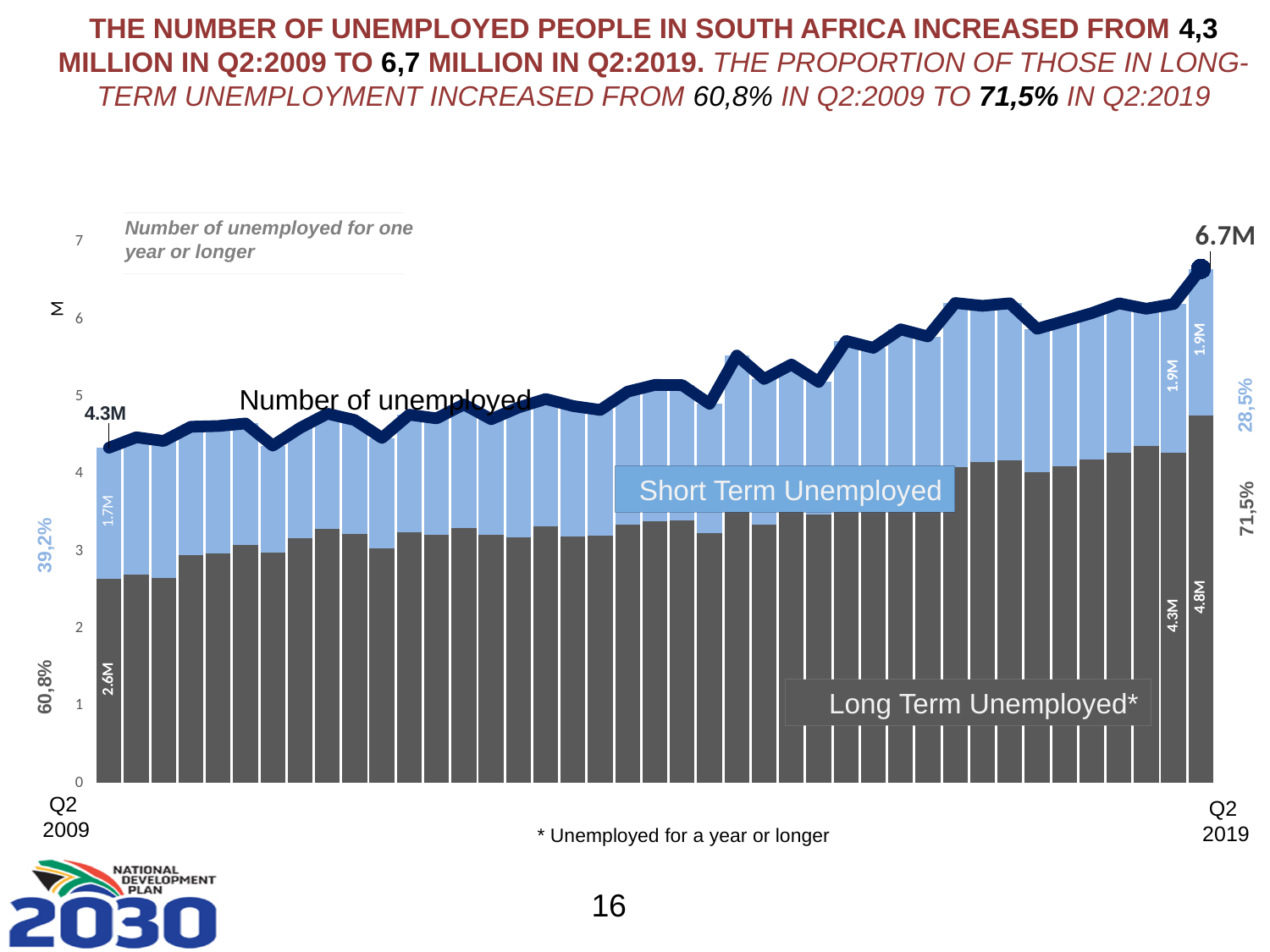
Does the number of unemployed generally rise or fall from Q2 2009 to Q2 2019? Rise What was the total number of unemployed people in Q2 2019 according to the chart? 6.7M By how much did the total number of unemployed increase from Q2 2009 to Q2 2019? 2.4M How many people were long term unemployed in Q2 2019? 4.8M In Q2 2019, which was larger: the number of long term unemployed or short term unemployed? Long term unemployed By how much did the number of long term unemployed increase from Q2 2009 to Q2 2019? 2.2M How many people were long term unemployed in Q2 2009? 2.6M How many people were short term unemployed in Q2 2009? 1.7M What kind of chart is used to show the long term and short term unemployed? Stacked bar chart What was the total number of unemployed people in Q2 2009 according to the chart? 4.3M What proportion of the unemployed were in long term unemployment in Q2 2019? 71,5% How many people were short term unemployed in Q2 2019? 1.9M